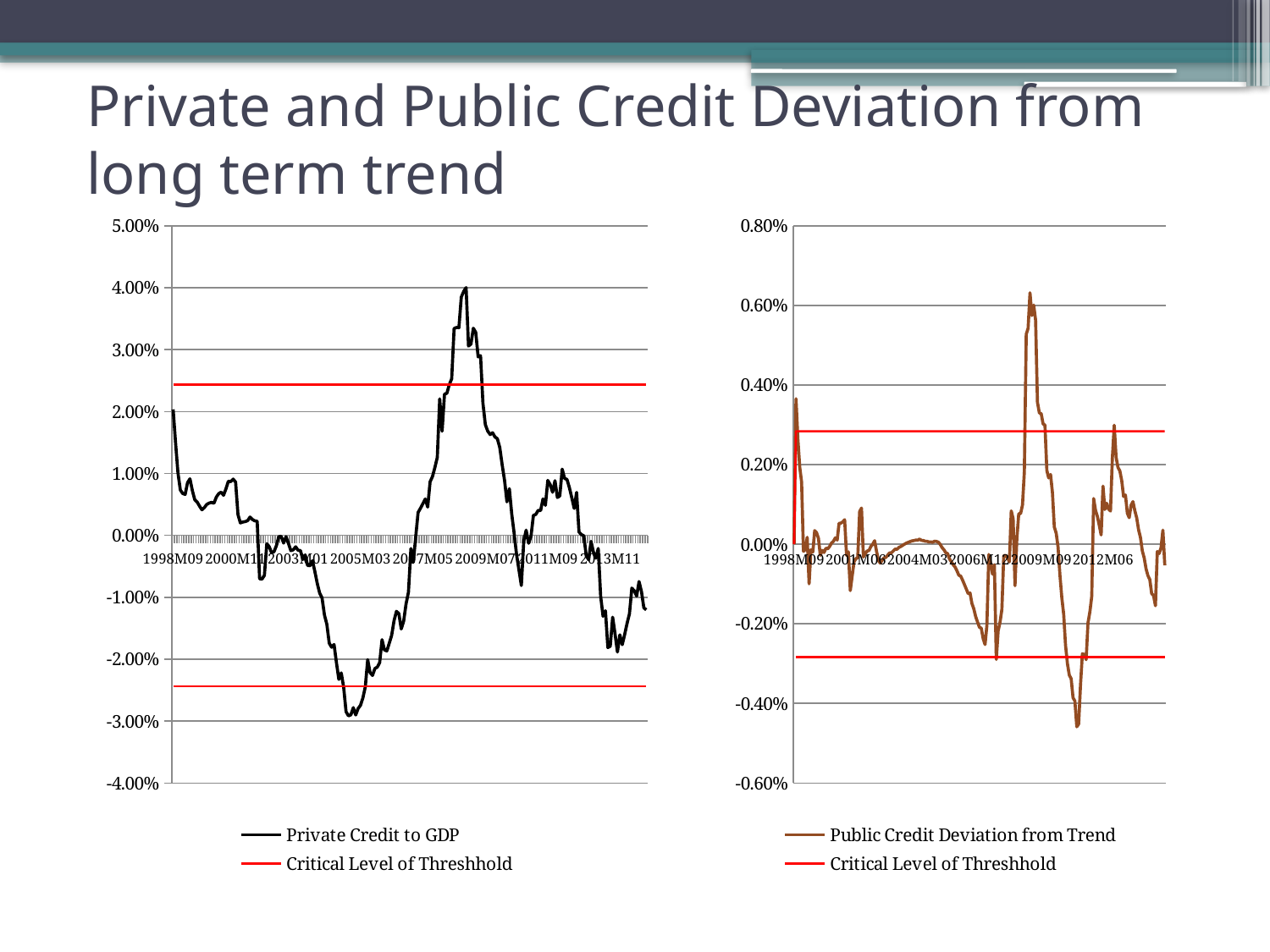
What is the first x-axis label shown on the left chart? 1998M09 In the left chart, is the highest value of the Private Credit to GDP line greater or less than 3.00%? greater In the left chart, is the lowest value of the Private Credit to GDP line greater or less than -2.00%? less How many series does the legend of the left chart list? 2 What is the name of the data series plotted in brown in the right chart? Public Credit Deviation from Trend How many series does the legend of the right chart list? 2 In the left chart, is the value of Private Credit to GDP at the first point (1998M09) greater or less than 1.00%? greater What kind of chart is the right chart on the slide? Line chart What kind of chart is the left chart on the slide? Line chart